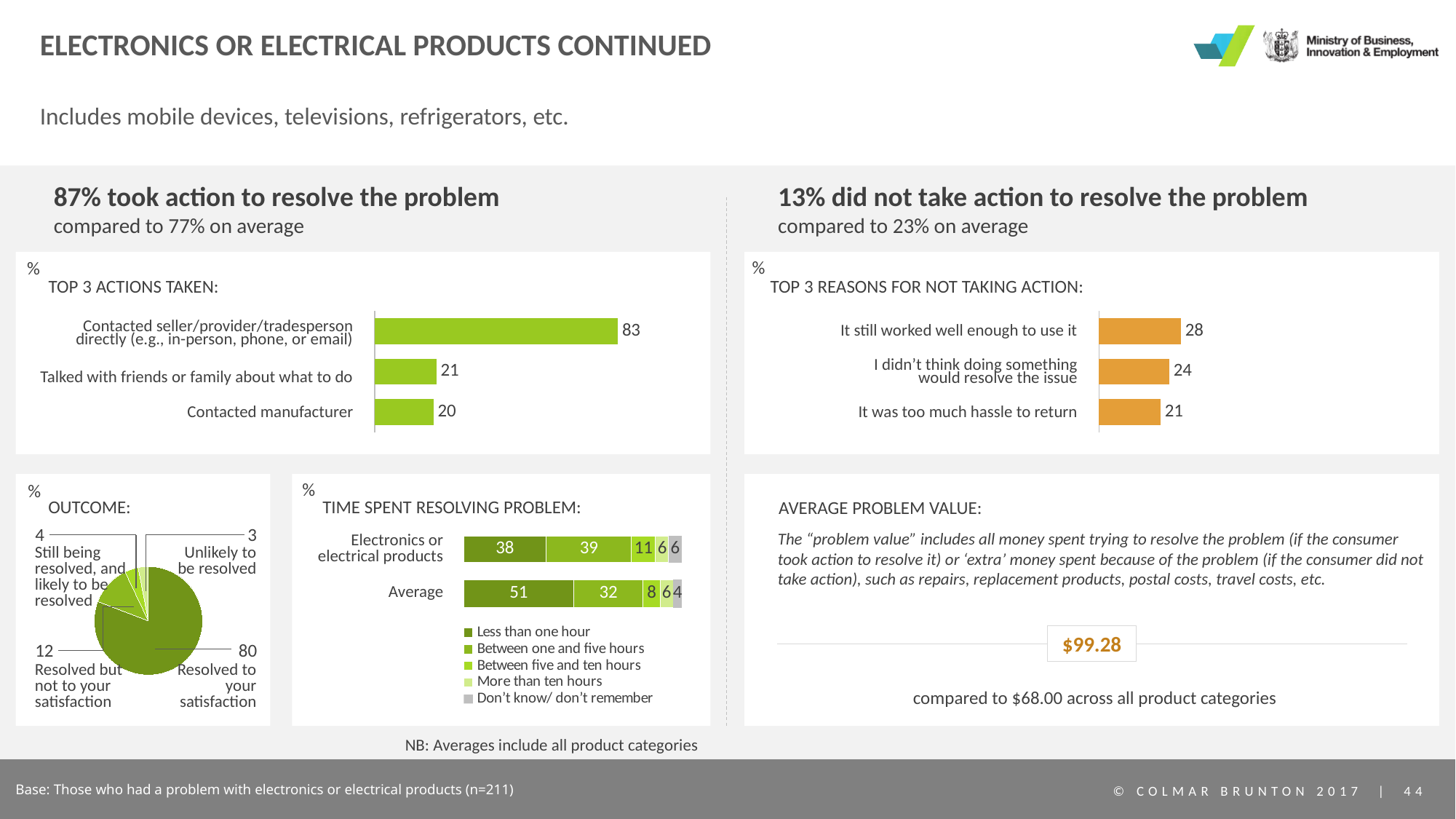
In the 'Top 3 actions taken' chart, which action has the highest value? Contacted seller/provider/tradesperson directly (e.g., in-person, phone, or email) In the 'Top 3 reasons for not taking action' chart, which reason has the lowest value? It was too much hassle to return In the 'Outcome' pie chart, what is the value for 'Resolved but not to your satisfaction'? 12 What kind of chart is the 'Outcome' chart? Pie chart In the 'Top 3 reasons for not taking action' chart, what is the value for 'I didn't think doing something would resolve the issue'? 24 In the 'Outcome' pie chart, how many slices are there? 4 In the 'Time spent resolving problem' chart, how many series does the legend list? 5 In the 'Top 3 actions taken' chart, what is the difference between 'Contacted seller/provider/tradesperson directly' and 'Talked with friends or family about what to do'? 62 In the 'Time spent resolving problem' chart, what is the 'Less than one hour' value for 'Electronics or electrical products'? 38 In the 'Top 3 reasons for not taking action' chart, what is the difference between 'It still worked well enough to use it' and 'It was too much hassle to return'? 7 In the 'Top 3 actions taken' chart, what is the value for 'Contacted manufacturer'? 20 In the 'Time spent resolving problem' chart, which is larger for 'Less than one hour': 'Electronics or electrical products' or 'Average'? Average